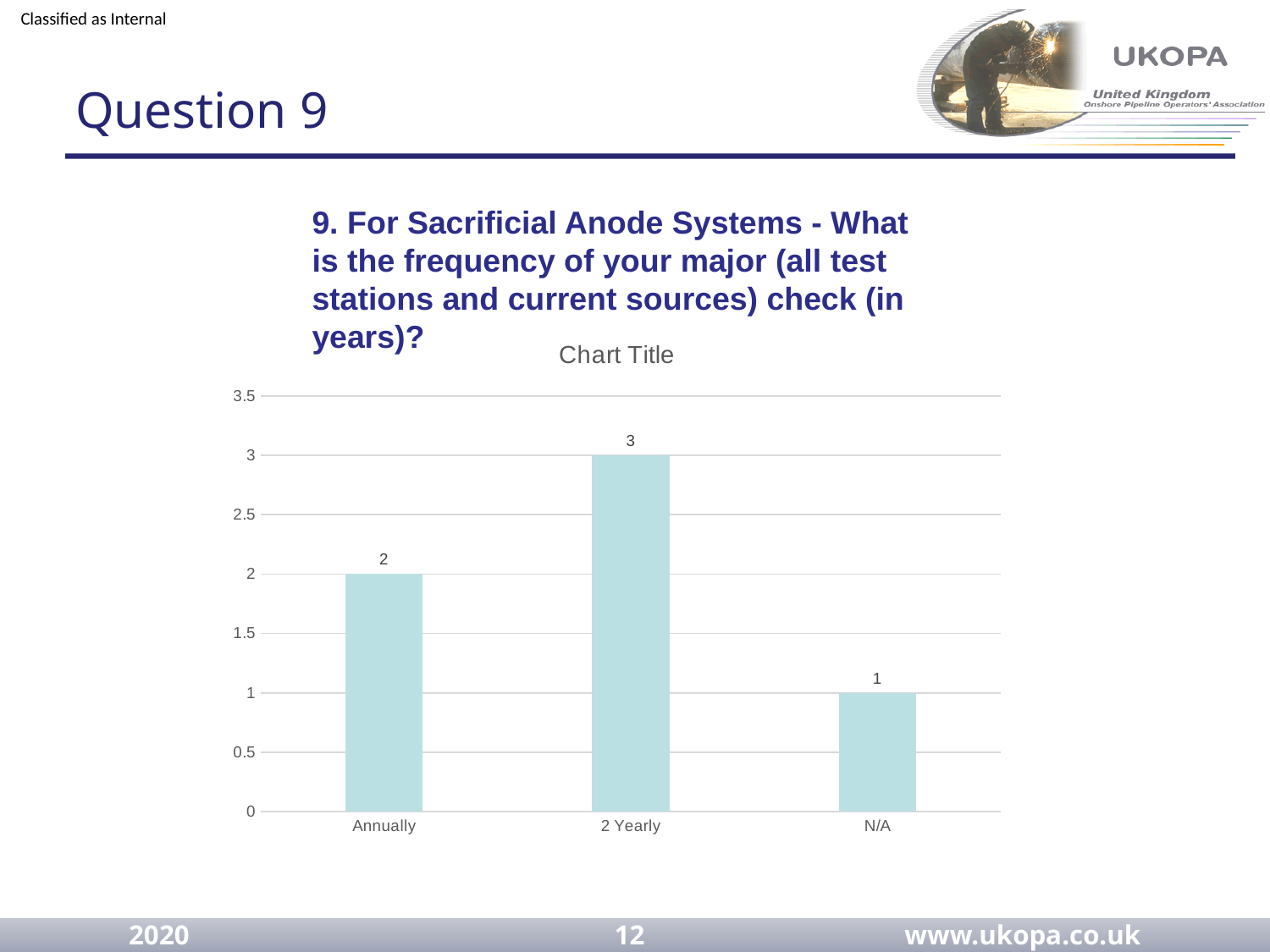
What is the value for N/A? 1 What is the value for Annually? 2 How many categories are shown on the x axis? 3 Which category has the highest value? 2 Yearly Is the value for 2 Yearly greater or less than 2.5? greater Which is larger, the value for Annually or the value for N/A? Annually What is the difference between the values for Annually and N/A? 1 What kind of chart is shown on the slide? bar chart What is the value for 2 Yearly? 3 What is the title shown above the chart? Chart Title What is the difference between the values for 2 Yearly and Annually? 1 Which category has the lowest value? N/A